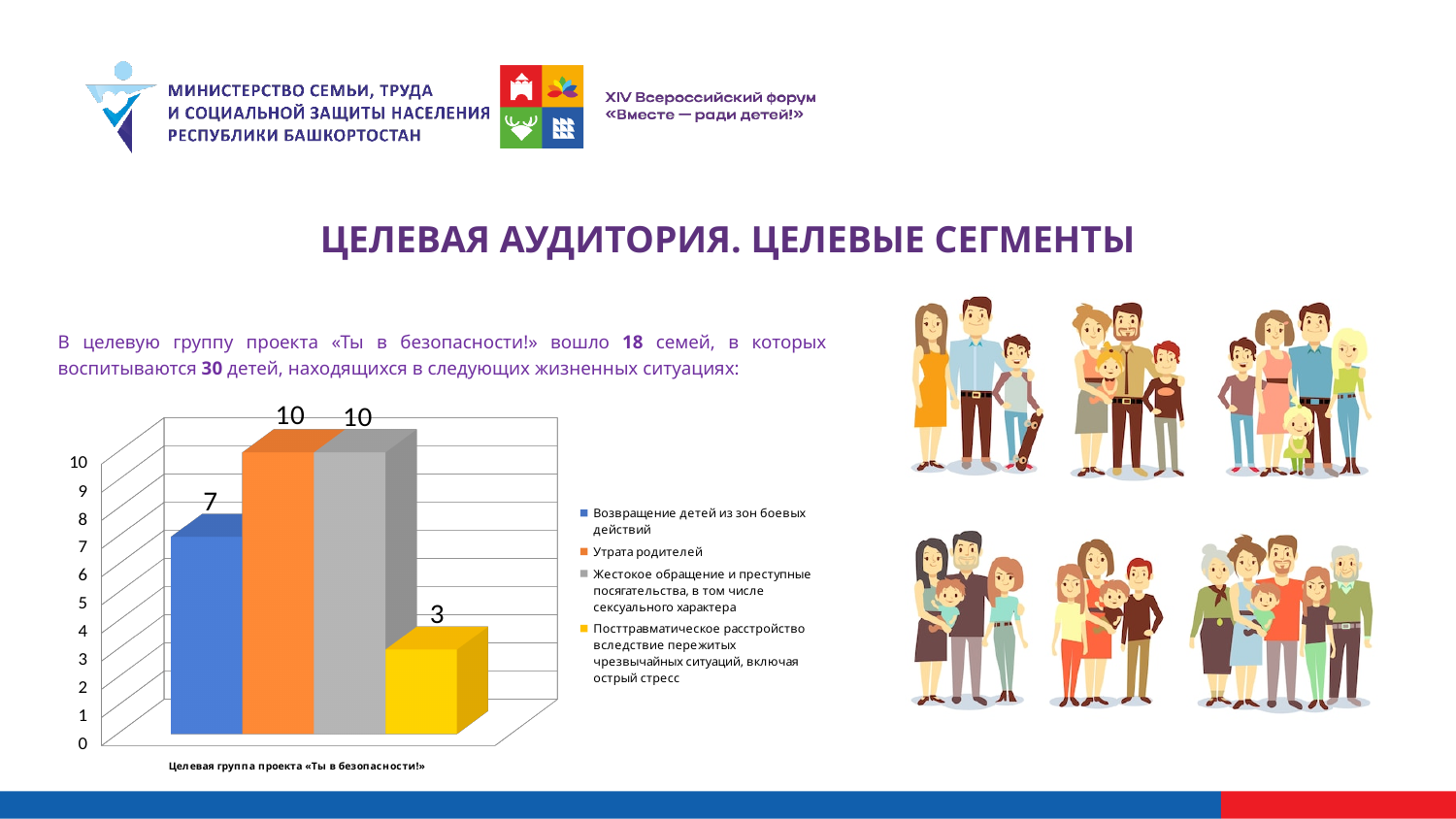
Is the value for «Возвращение детей из зон боевых действий» greater or less than 5? greater What is the label on the category axis of the chart? Целевая группа проекта «Ты в безопасности!» What is the value for «Утрата родителей»? 10 Which series has the lowest value? Посттравматическое расстройство вследствие пережитых чрезвычайных ситуаций, включая острый стресс What kind of chart is shown on the slide? bar chart What is the value for «Жестокое обращение и преступные посягательства, в том числе сексуального характера»? 10 Which is larger: the value for «Возвращение детей из зон боевых действий» or the value for «Посттравматическое расстройство вследствие пережитых чрезвычайных ситуаций, включая острый стресс»? Возвращение детей из зон боевых действий How many series does the legend list? 4 What is the value for «Посттравматическое расстройство вследствие пережитых чрезвычайных ситуаций, включая острый стресс»? 3 What is the difference between the values for «Утрата родителей» and «Посттравматическое расстройство вследствие пережитых чрезвычайных ситуаций, включая острый стресс»? 7 What is the value for «Возвращение детей из зон боевых действий»? 7 What is the difference between the values for «Утрата родителей» and «Возвращение детей из зон боевых действий»? 3